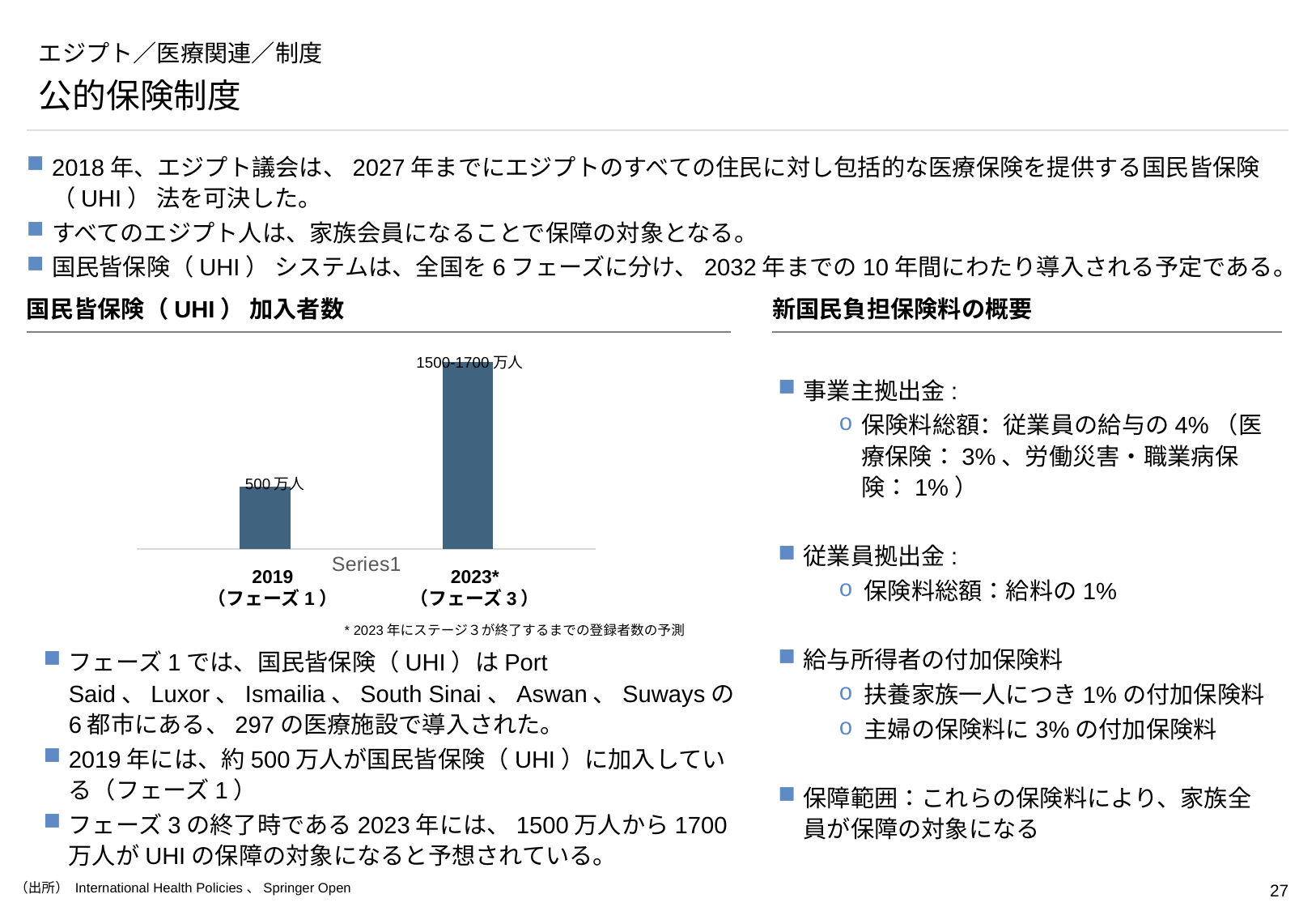
How many bars are plotted in the 国民皆保険（UHI）加入者数 chart? 2 In the 国民皆保険（UHI）加入者数 chart, which is larger: the value for 2019 or the value for 2023*? 2023* What is the value shown for 2023* (フェーズ3) in the 国民皆保険（UHI）加入者数 chart? 1500-1700万人 What is the value shown for 2019 (フェーズ1) in the 国民皆保険（UHI）加入者数 chart? 500万人 Which category has the highest bar in the 国民皆保険（UHI）加入者数 chart? 2023*（フェーズ3） Do the values in the 国民皆保険（UHI）加入者数 chart rise or fall from 2019 to 2023*? Rise Which category has the lowest bar in the 国民皆保険（UHI）加入者数 chart? 2019（フェーズ1） What does the asterisk footnote below the chart say about the 2023* value? 2023年にステージ3が終了するまでの登録者数の予測 What is the title of the chart on the slide? 国民皆保険（UHI）加入者数 What kind of chart is used to show 国民皆保険（UHI）加入者数? Bar chart